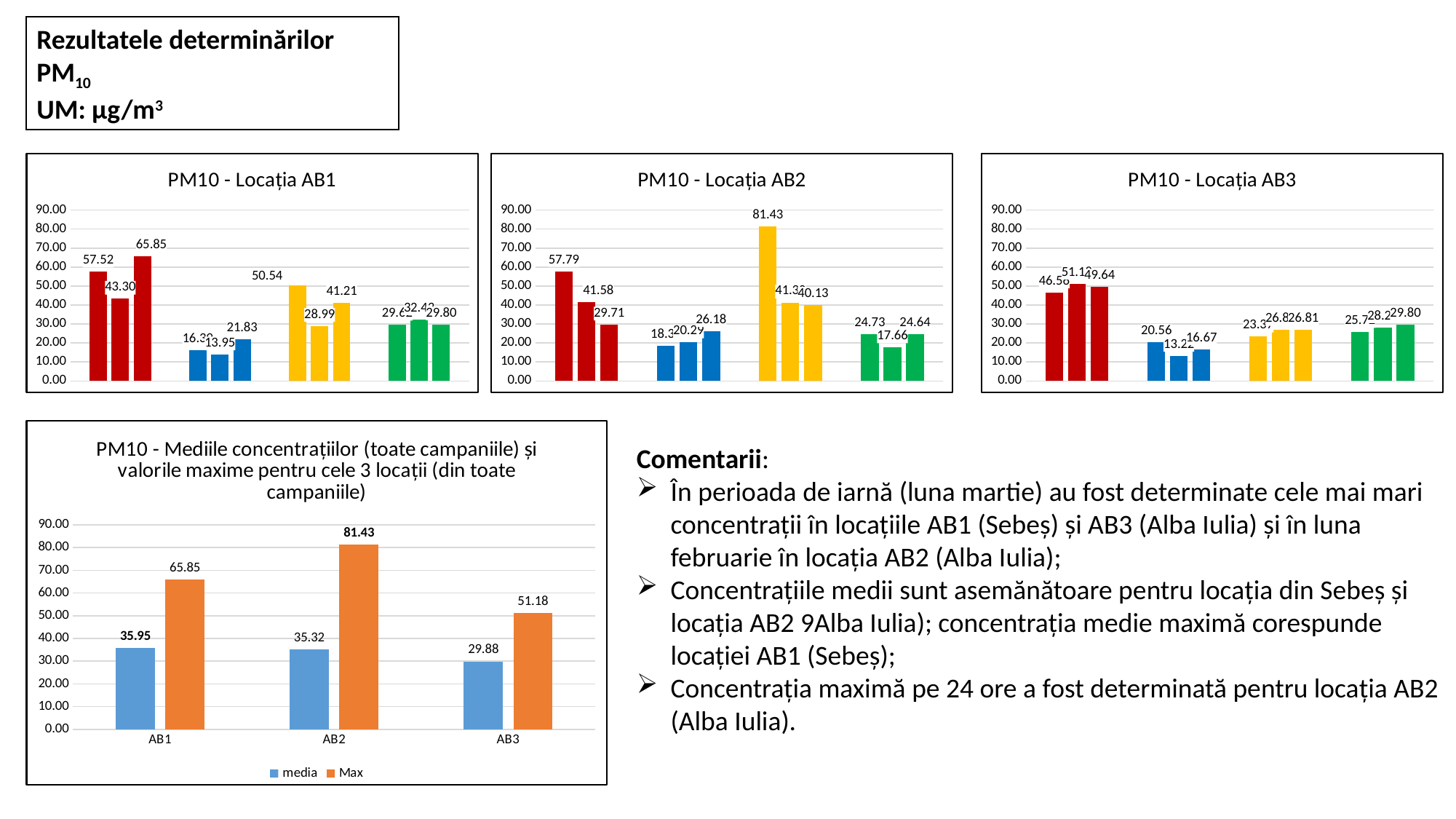
In the bottom chart (PM10 - Mediile concentrațiilor...), which location has the lowest media value? AB3 In the bottom chart (PM10 - Mediile concentrațiilor...), what is the Max value for AB2? 81.43 In the bottom chart (PM10 - Mediile concentrațiilor...), what are the two legend entries? media, Max What kind of chart is the bottom chart (PM10 - Mediile concentrațiilor...)? bar chart In the bottom chart (PM10 - Mediile concentrațiilor...), what is the difference between the Max and media values for AB1? 29.90 In the chart titled PM10 - Locația AB2, what is the highest value shown? 81.43 In the bottom chart (PM10 - Mediile concentrațiilor...), which is larger: the media value for AB1 or for AB2? AB1 In the bottom chart (PM10 - Mediile concentrațiilor...), which location has the highest Max value? AB2 In the chart titled PM10 - Locația AB1, what is the highest value shown? 65.85 In the bottom chart (PM10 - Mediile concentrațiilor...), how many series does the legend list? 2 In the bottom chart (PM10 - Mediile concentrațiilor...), what is the media value for AB3? 29.88 In the bottom chart (PM10 - Mediile concentrațiilor...), how many locations are shown on the x axis? 3